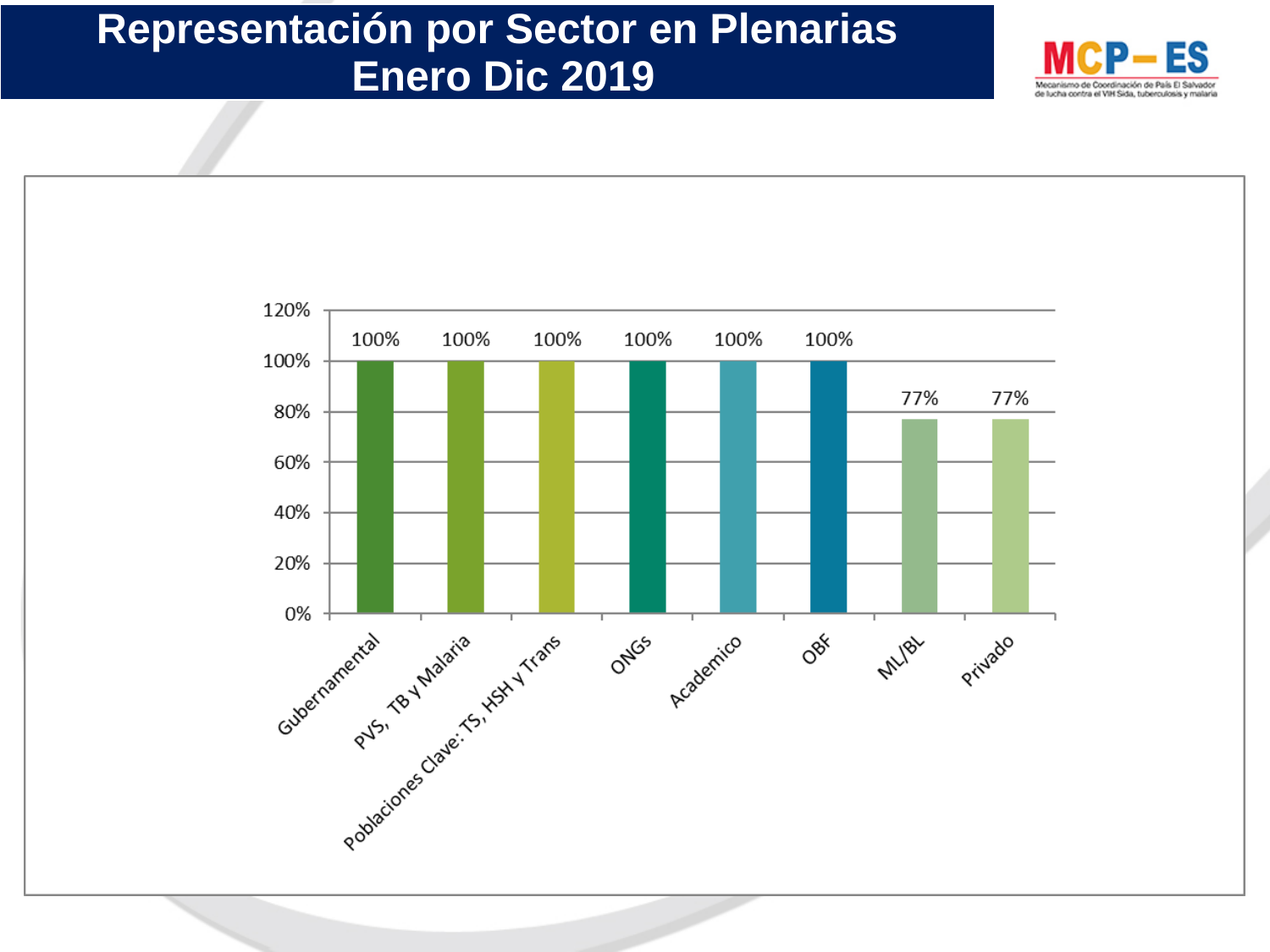
What is the value for OBF? 100% How many categories are shown on the x axis? 8 What is the value for Gubernamental? 100% What is the difference between the value for ONGs and the value for Privado? 23% How many categories have a value of 100%? 6 What is the title of the slide? Representación por Sector en Plenarias Enero Dic 2019 What is the value for ML/BL? 77% Is the value for Privado greater or less than 80%? less Which is larger, the value for PVS, TB y Malaria or the value for ML/BL? PVS, TB y Malaria What is the value for Academico? 100% What is the value for Privado? 77% What kind of chart is shown on the slide? bar chart